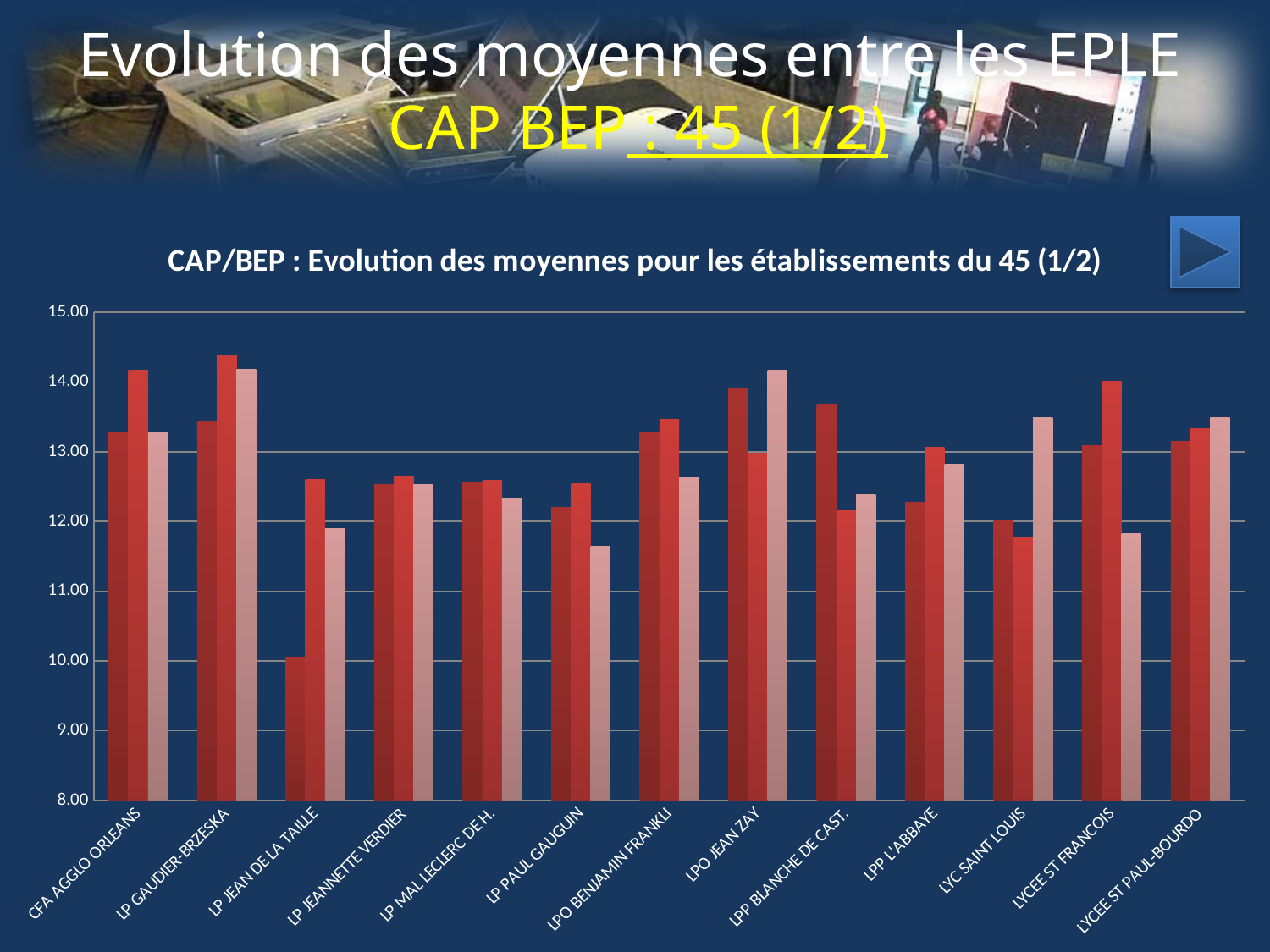
Is the value of the first (leftmost) bar for LP JEAN DE LA TAILLE greater or less than 11.00? less Is the value of the third (rightmost) bar for LYCEE ST FRANCOIS greater or less than 12.00? less What kind of chart is shown on the slide? bar chart Is the value of the third (rightmost) bar for LP PAUL GAUGUIN greater or less than 12.00? less Which establishment has the highest bar in the chart? LP GAUDIER-BRZESKA Which is larger: the third (rightmost) bar for LYC SAINT LOUIS or the third (rightmost) bar for LYCEE ST FRANCOIS? LYC SAINT LOUIS What is the title of the chart? CAP/BEP : Evolution des moyennes pour les établissements du 45 (1/2) How many establishments (categories) are shown on the x axis of the chart? 13 Which is larger: the first (leftmost) bar for CFA AGGLO ORLEANS or the first (leftmost) bar for LP JEAN DE LA TAILLE? CFA AGGLO ORLEANS How many bars are plotted for each establishment in the chart? 3 Which establishment has the lowest bar in the chart? LP JEAN DE LA TAILLE